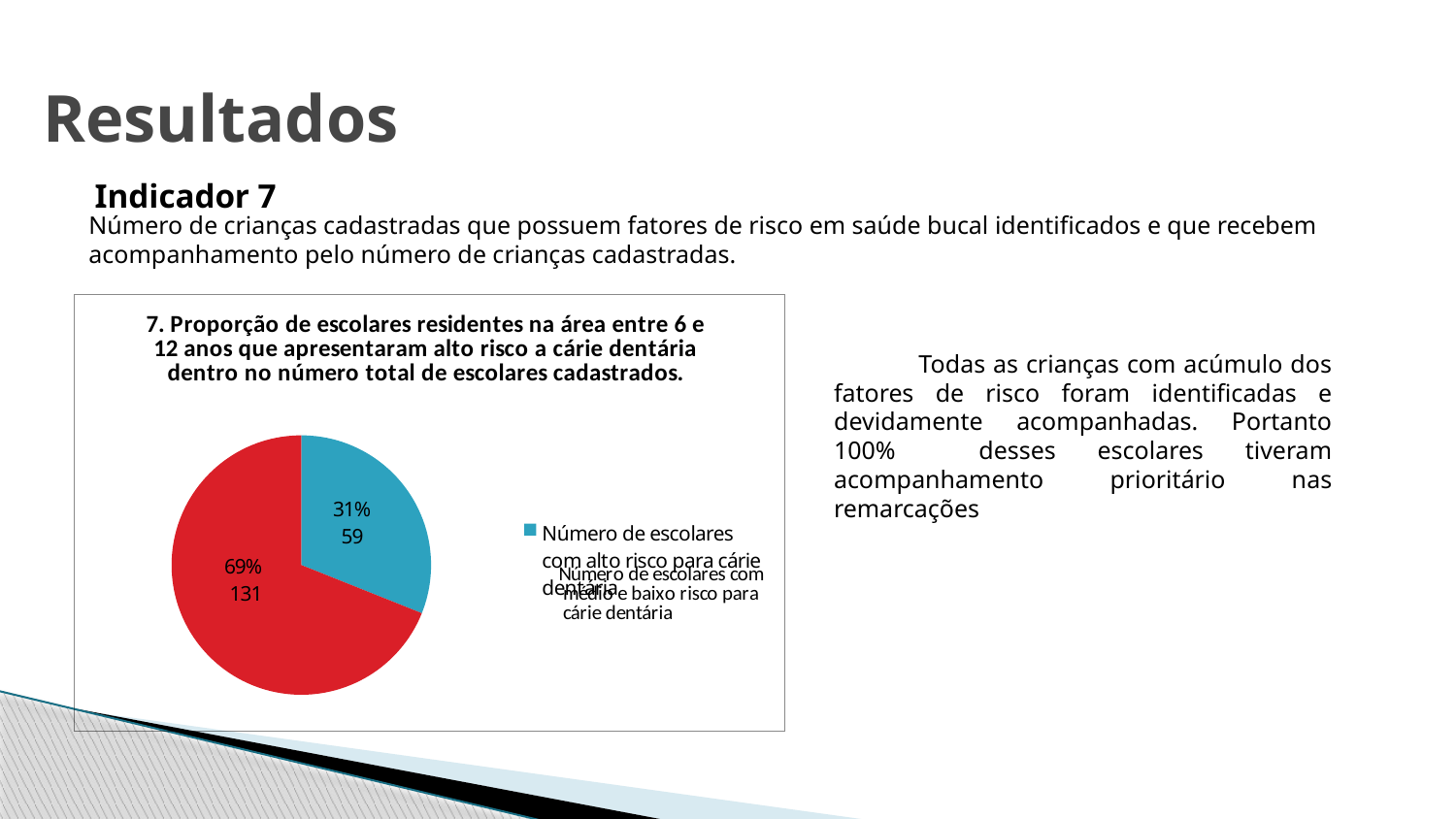
What is the difference in number of students between the 'médio e baixo risco' slice and the 'alto risco' slice? 72 What is the number of students shown for the slice 'Número de escolares com médio e baixo risco para cárie dentária'? 131 What is the total number of students represented by the two slices of the pie chart? 190 What percentage of the pie is the slice for 'Número de escolares com médio e baixo risco para cárie dentária'? 69% What colour is the slice for 'Número de escolares com alto risco para cárie dentária'? blue What kind of chart is shown on the slide? pie chart Which slice of the pie chart is the smallest? Número de escolares com alto risco para cárie dentária How many slices does the pie chart have? 2 What is the number of students shown for the slice 'Número de escolares com alto risco para cárie dentária'? 59 What percentage of the pie is the slice for 'Número de escolares com alto risco para cárie dentária'? 31% Which slice of the pie chart is the largest? Número de escolares com médio e baixo risco para cárie dentária